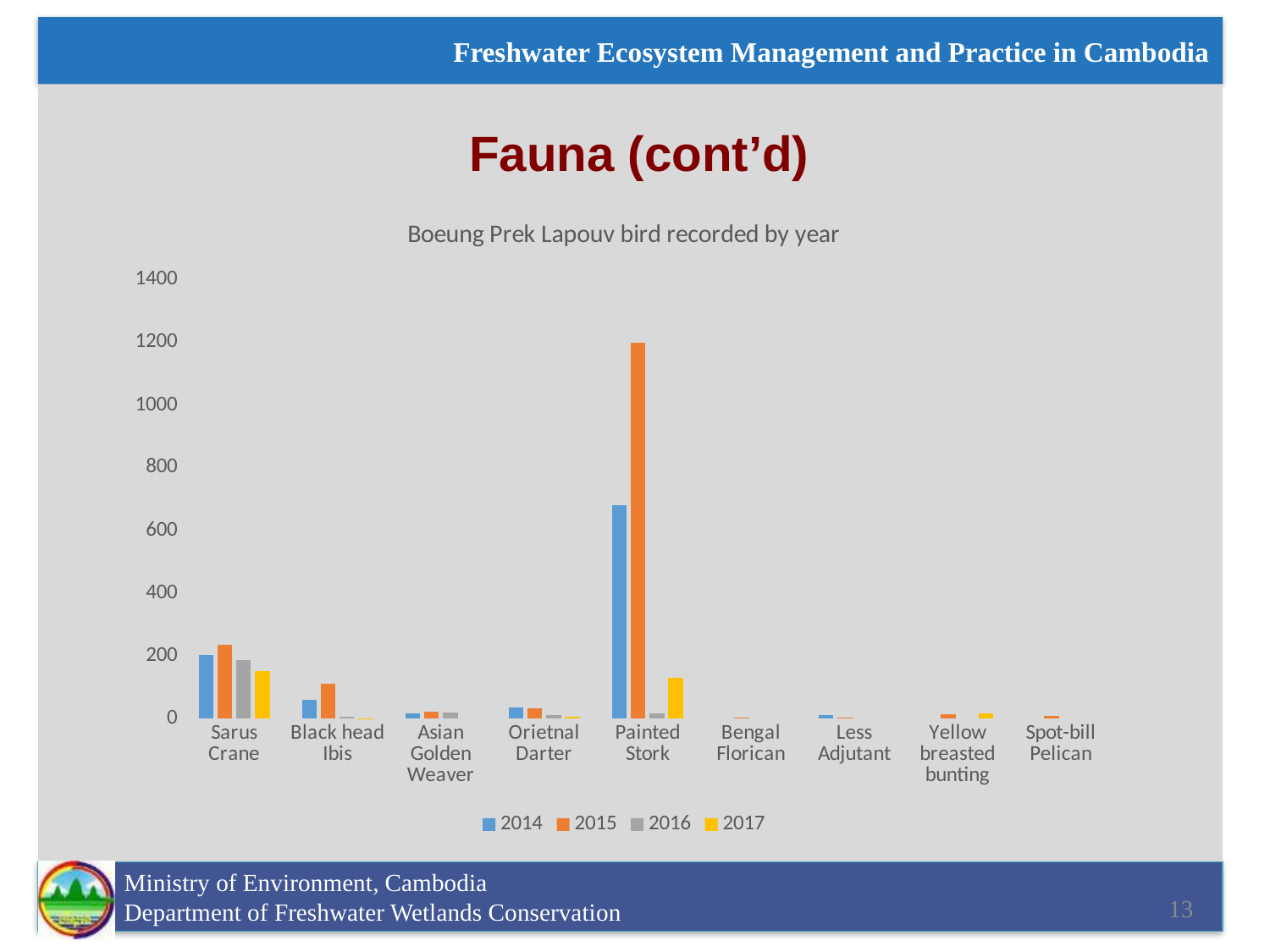
How many bird species categories are shown on the x axis? 9 Is the 2015 value for Painted Stork greater or less than 1000? greater Is the 2017 value for Sarus Crane greater or less than 200? less What kind of chart is shown on the slide? bar chart What is the title of the chart? Boeung Prek Lapouv bird recorded by year Is the 2014 value for Painted Stork greater or less than 600? greater How many series does the legend list? 4 Which has the larger 2015 value, Sarus Crane or Black head Ibis? Sarus Crane Which bird species has the highest recorded value for 2015? Painted Stork Which series is shown in orange in the legend? 2015 For Painted Stork, which year has the larger value, 2014 or 2015? 2015